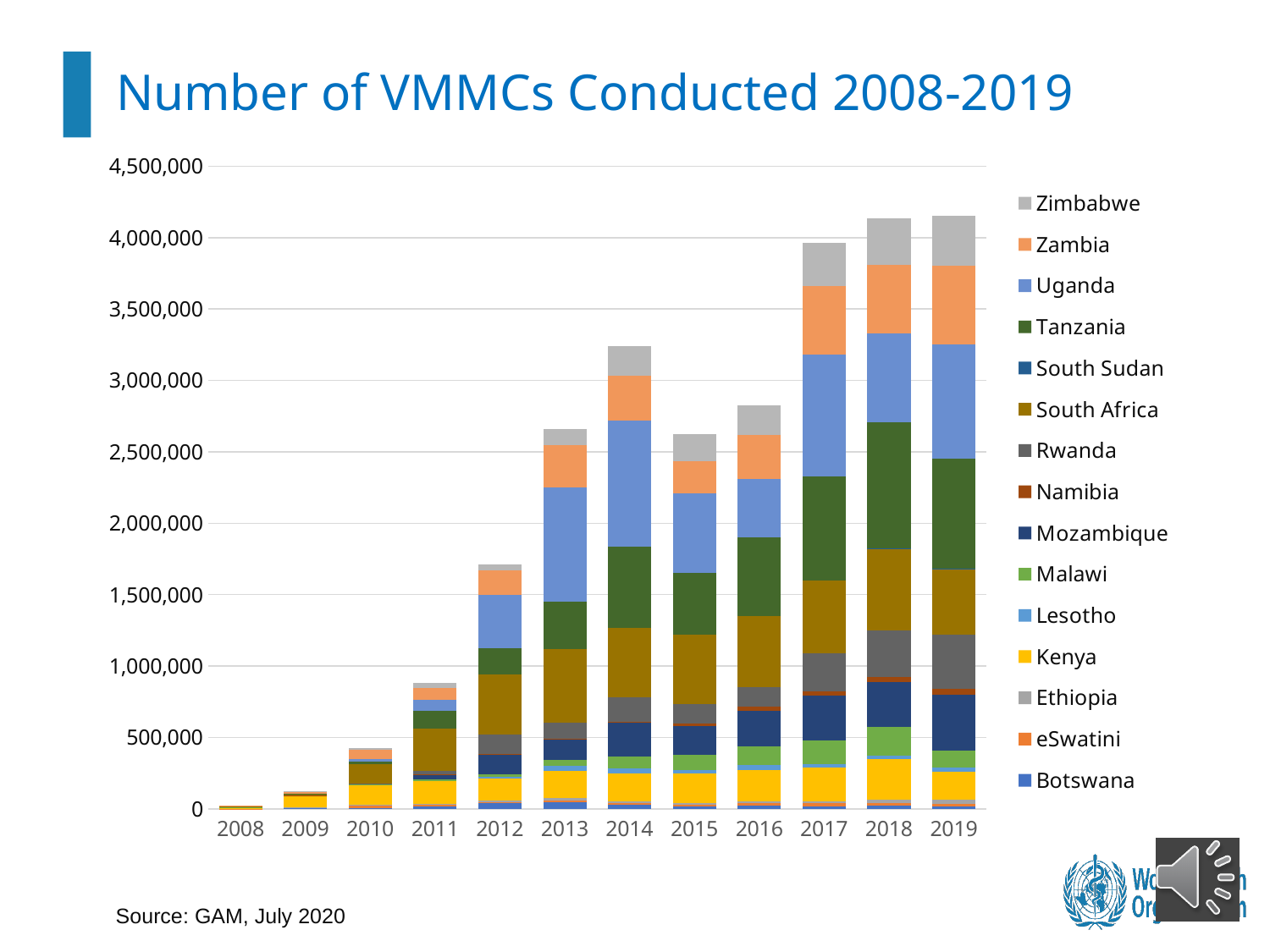
What is the title of the chart? Number of VMMCs Conducted 2008-2019 Which year has the larger total number of VMMCs, 2016 or 2017? 2017 What kind of chart is shown on the slide? Stacked bar chart Which year has the larger total number of VMMCs, 2014 or 2015? 2014 How many years are shown along the x axis of the chart? 12 Do the total numbers of VMMCs rise or fall from 2008 to 2014? rise Is the total number of VMMCs in 2017 greater or less than 3,500,000? greater Is the total number of VMMCs in 2011 greater or less than 1,000,000? less Which year has the lowest total number of VMMCs? 2008 Is the total number of VMMCs in 2015 greater or less than 3,000,000? less How many countries does the legend list? 15